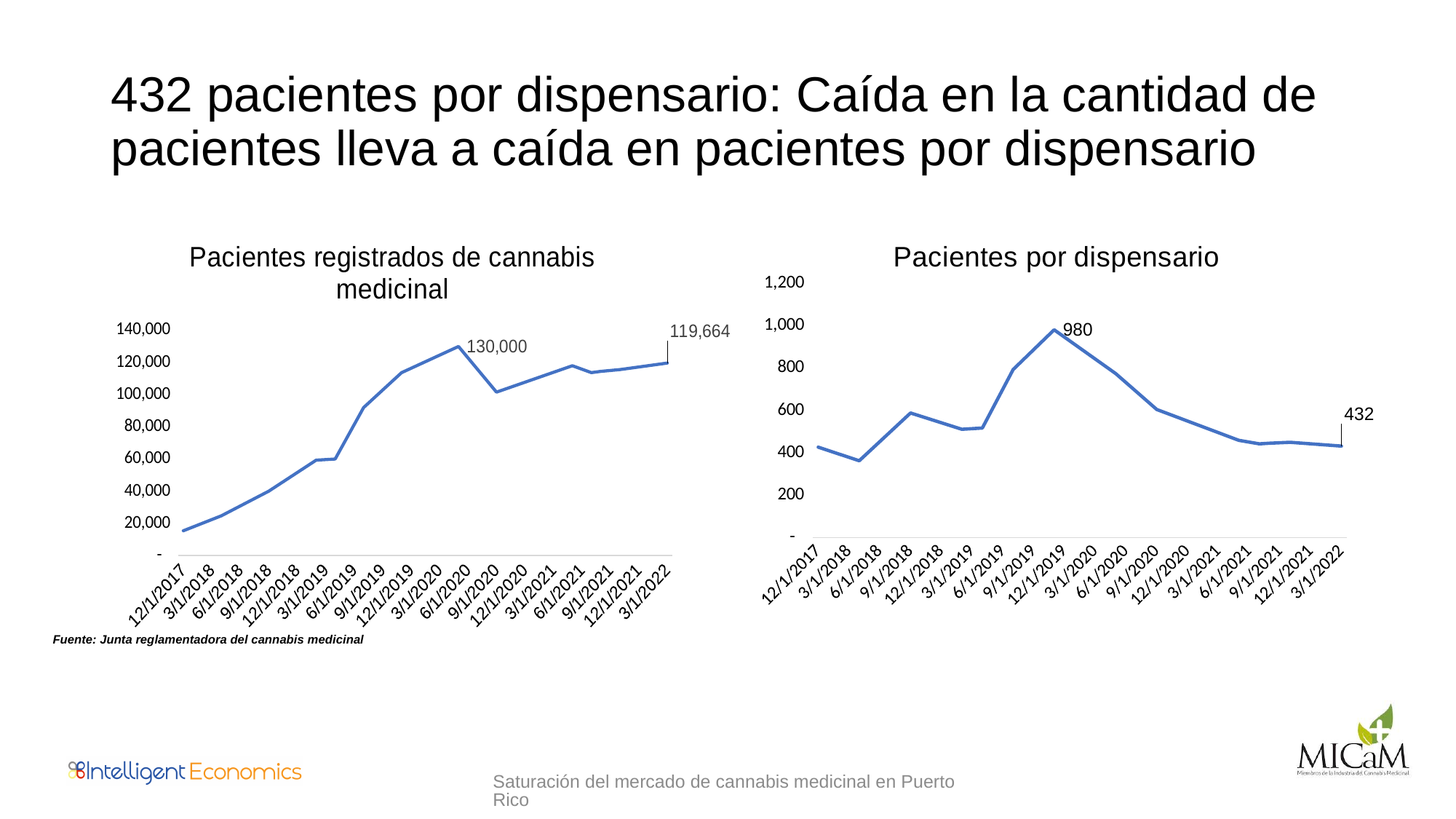
How many dates are shown on the x axis of the 'Pacientes por dispensario' chart? 18 In the 'Pacientes por dispensario' chart, at which date does the line reach its highest value? 12/1/2019 In the 'Pacientes registrados de cannabis medicinal' chart, at which date is the value lowest? 12/1/2017 In the 'Pacientes registrados de cannabis medicinal' chart, what is the difference between the value at 6/1/2020 and the value at 3/1/2022? 10,336 In the 'Pacientes registrados de cannabis medicinal' chart, is the value at 12/1/2017 greater or less than 20,000? less In the 'Pacientes por dispensario' chart, what is the difference between the value at 12/1/2019 and the value at 3/1/2022? 548 In the 'Pacientes registrados de cannabis medicinal' chart, what is the value at 3/1/2022? 119,664 In the 'Pacientes registrados de cannabis medicinal' chart, what is the value labelled at 6/1/2020? 130,000 What type of chart is the 'Pacientes por dispensario' chart? line chart In the 'Pacientes por dispensario' chart, what is the value at 3/1/2022? 432 In the 'Pacientes por dispensario' chart, what is the value at 12/1/2019? 980